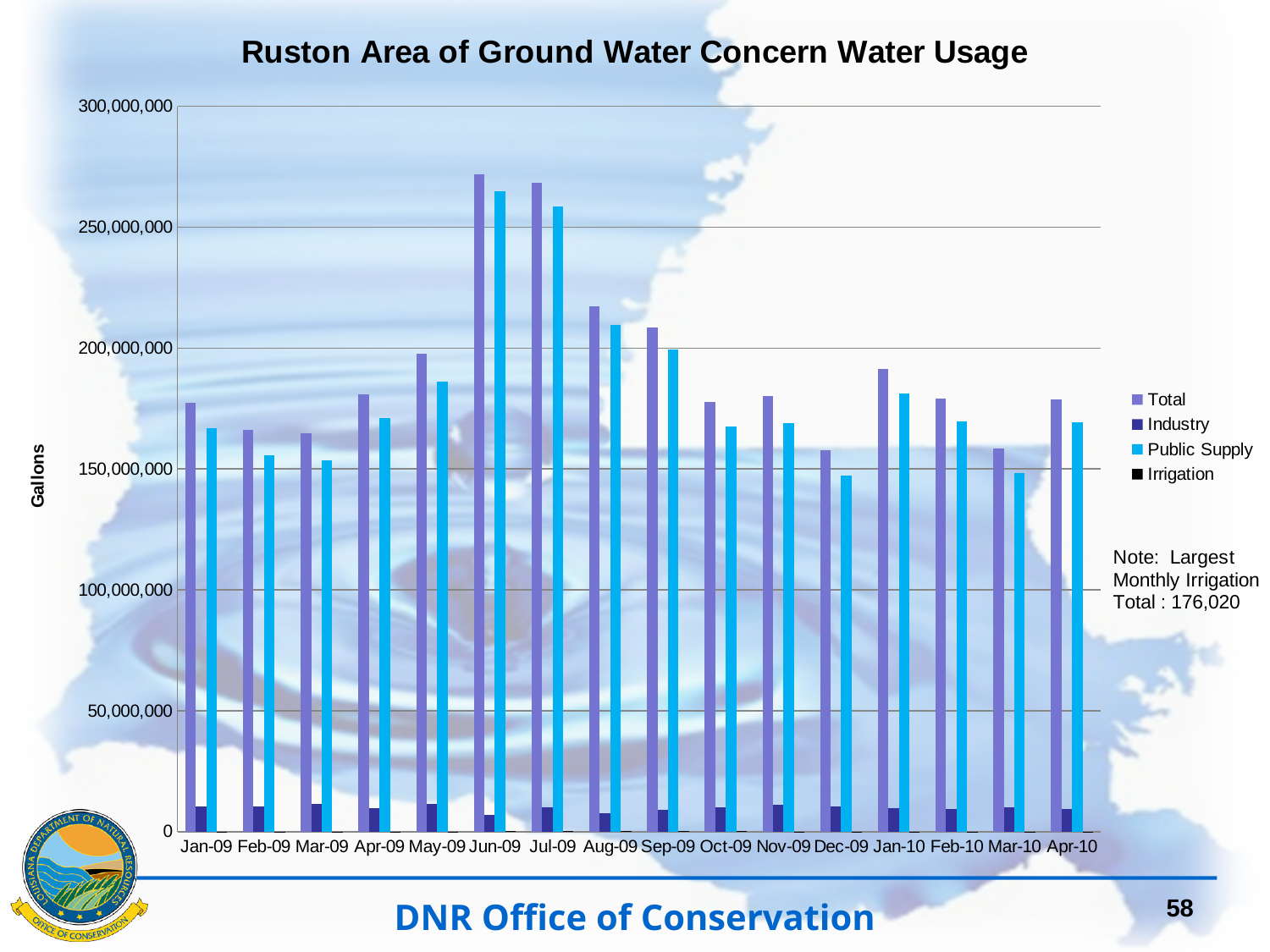
Is the Total value for Aug-09 greater or less than 200,000,000? greater Is the Total value for Jun-09 greater or less than 250,000,000? greater Is the Public Supply value for Dec-09 greater or less than 150,000,000? less Which is larger, the Total for Aug-09 or the Total for Oct-09? Aug-09 According to the note on the slide, what is the largest monthly Irrigation total? 176,020 What kind of chart is shown on the slide? bar chart What is the label on the y axis? Gallons Which month has the highest Total bar? Jun-09 How many series does the legend list? 4 Does the Total value rise or fall from Jun-09 to Dec-09? fall How many months are shown along the x axis? 16